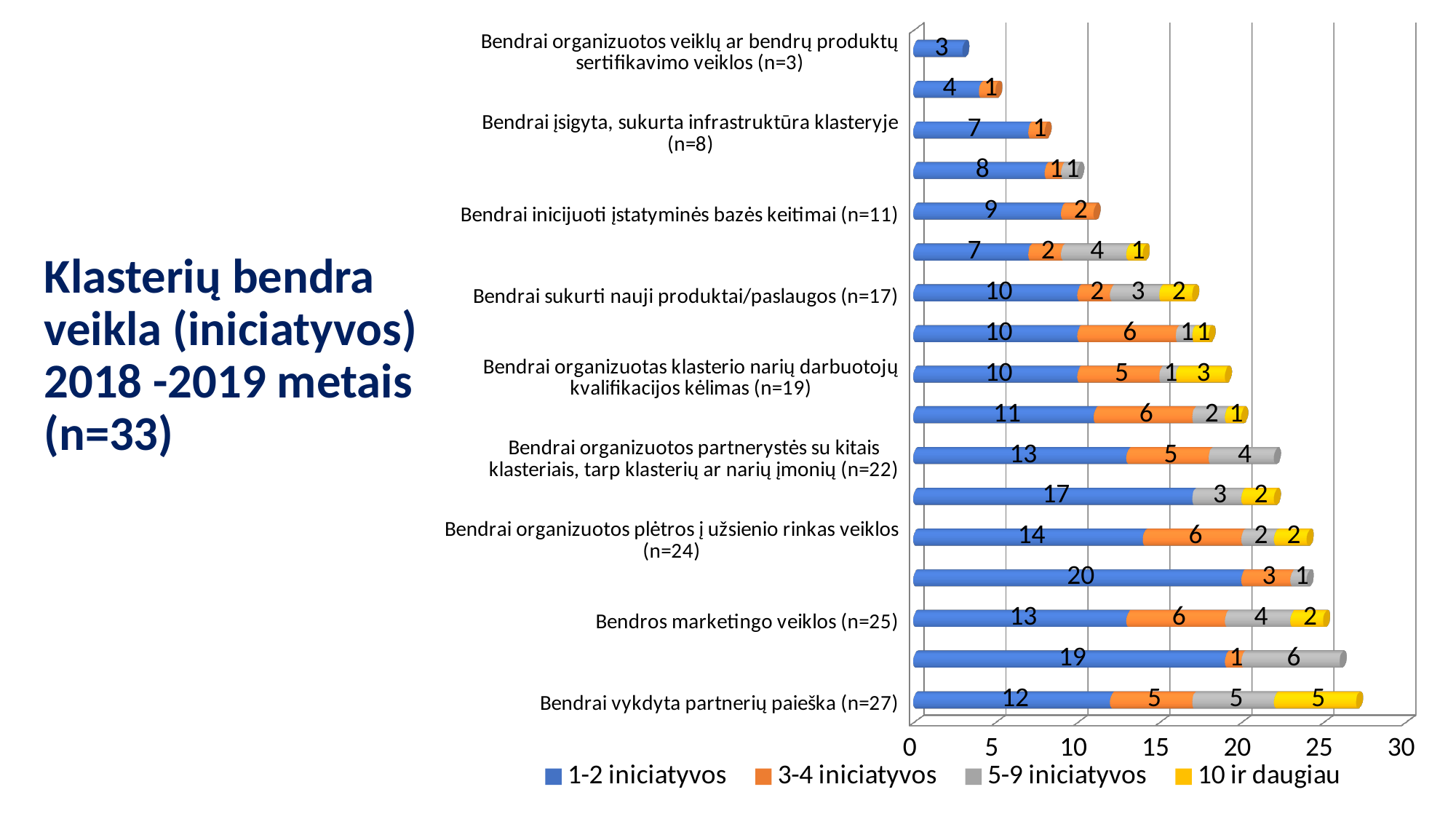
What is the total of the stacked bar for "Bendros marketingo veiklos (n=25)"? 25 Which category has the longest total bar? Bendrai vykdyta partnerių paieška (n=27) Which category has the shortest total bar? Bendrai organizuotos veiklų ar bendrų produktų sertifikavimo veiklos (n=3) What is the value of the "3-4 iniciatyvos" series for "Bendros marketingo veiklos (n=25)"? 6 How many series does the legend list? 4 What is the value of the "1-2 iniciatyvos" series for "Bendrai vykdyta partnerių paieška (n=27)"? 12 What is the total of the stacked bar for "Bendrai vykdyta partnerių paieška (n=27)"? 27 What kind of chart is shown on the slide? Stacked bar chart What is the value of the "10 ir daugiau" series for "Bendrai vykdyta partnerių paieška (n=27)"? 5 Which has the larger "1-2 iniciatyvos" value: "Bendrai organizuotos plėtros į užsienio rinkas veiklos (n=24)" or "Bendros marketingo veiklos (n=25)"? Bendrai organizuotos plėtros į užsienio rinkas veiklos (n=24) What is the value of the "5-9 iniciatyvos" series for "Bendrai organizuotos partnerystės su kitais klasteriais, tarp klasterių ar narių įmonių (n=22)"? 4 What is the difference between the "3-4 iniciatyvos" values for "Bendros marketingo veiklos (n=25)" and "Bendrai vykdyta partnerių paieška (n=27)"? 1